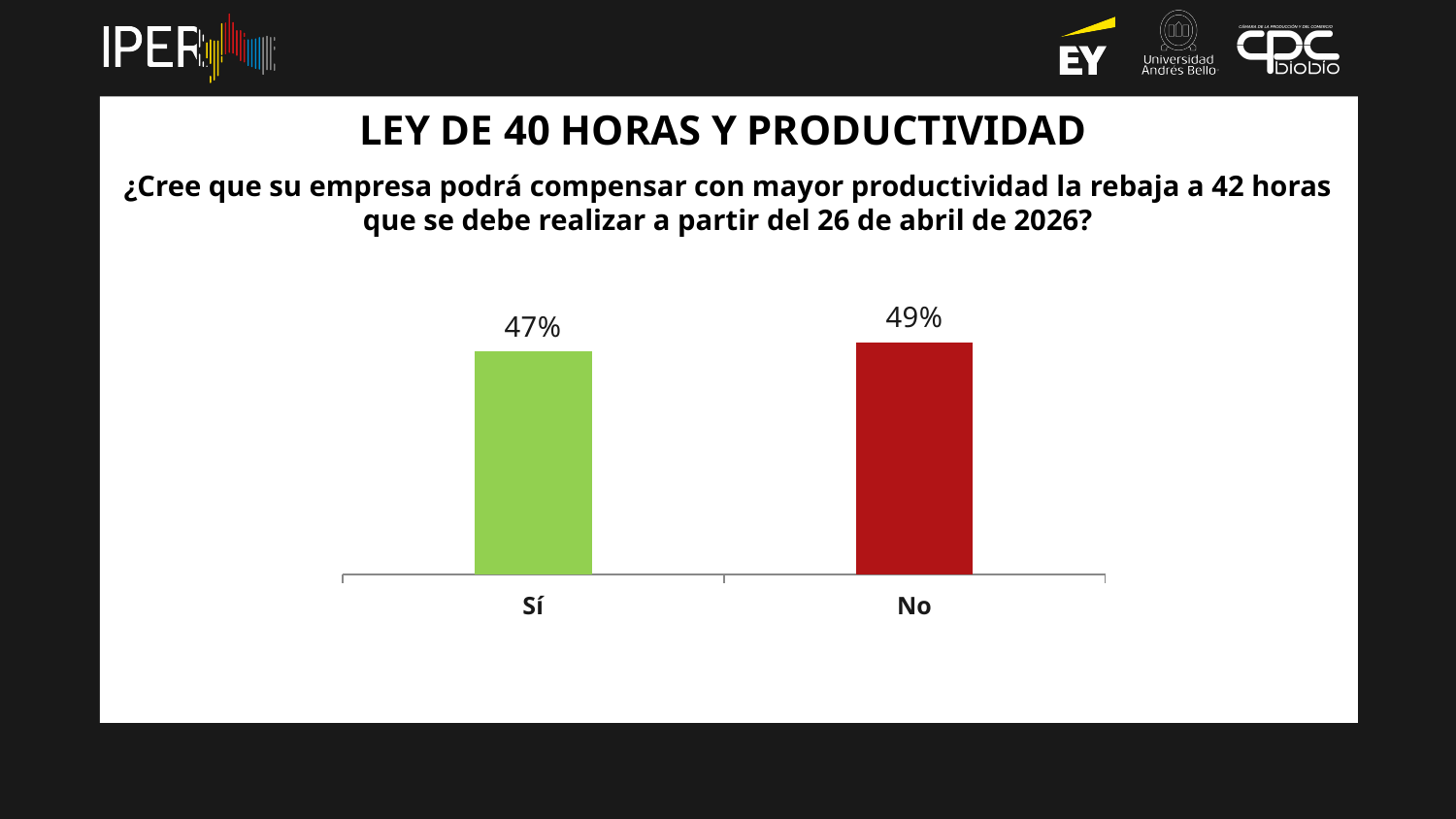
What is the value for No? 49% What is the title of the slide? LEY DE 40 HORAS Y PRODUCTIVIDAD What colour is the bar for No? Red Which is larger, the value for Sí or the value for No? No Which category has the lowest value? Sí How many categories are shown in the chart? 2 What is the value for Sí? 47% What is the difference between the values for No and Sí? 2% What kind of chart is shown on the slide? Bar chart Which category has the highest value? No